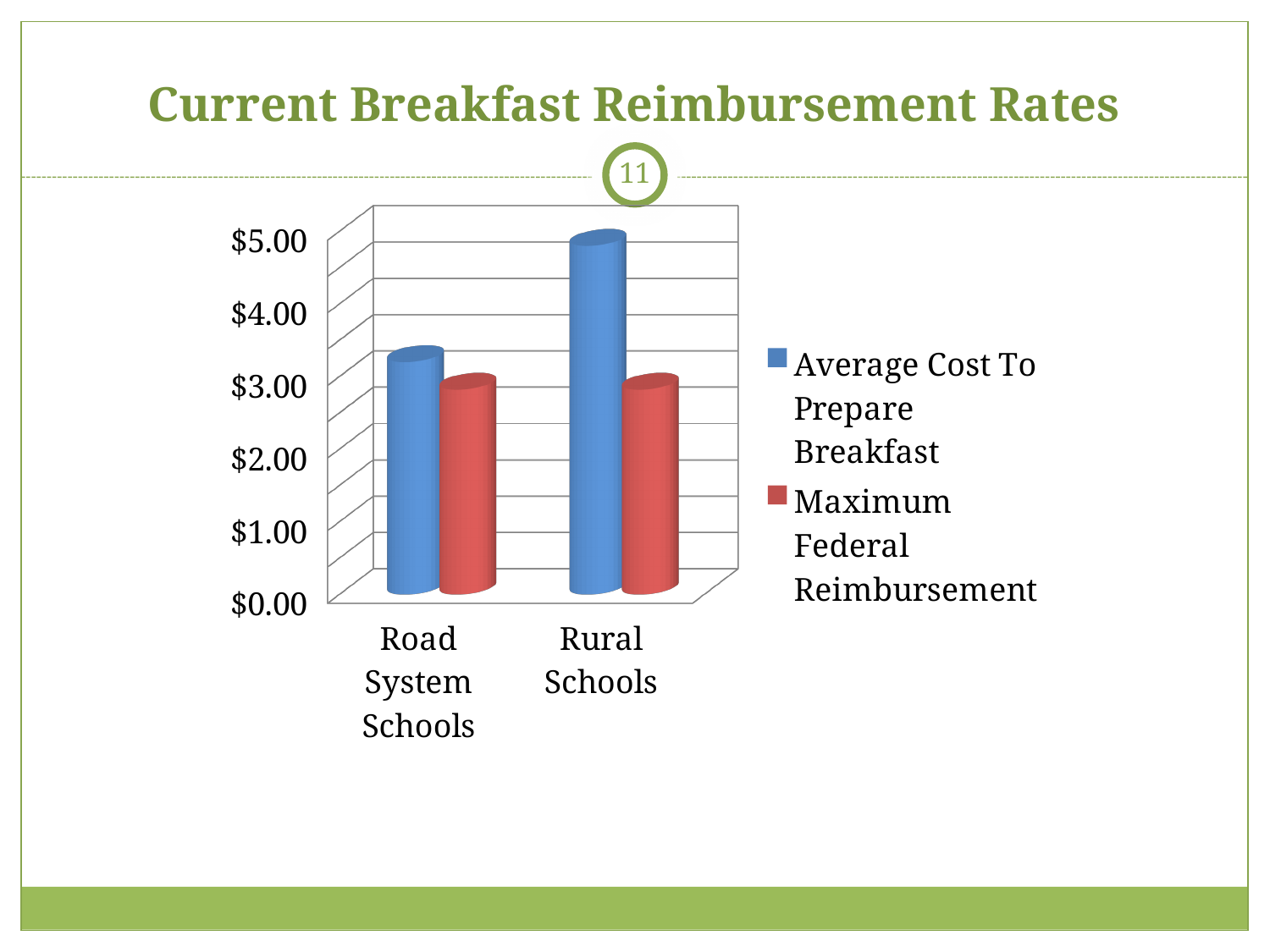
How many series does the legend list? 2 For Rural Schools, which is larger: the Average Cost To Prepare Breakfast or the Maximum Federal Reimbursement? Average Cost To Prepare Breakfast Is the Average Cost To Prepare Breakfast for Road System Schools greater or less than $3.00? greater What is the title of the chart on the slide? Current Breakfast Reimbursement Rates Which series is shown in red? Maximum Federal Reimbursement Is the Maximum Federal Reimbursement for Rural Schools greater or less than $2.00? greater Which category has the higher Average Cost To Prepare Breakfast? Rural Schools Is the Average Cost To Prepare Breakfast for Rural Schools greater or less than $4.00? greater How many categories are shown on the x axis? 2 What kind of chart is shown on the slide? bar chart Which is larger: the Average Cost To Prepare Breakfast for Rural Schools or for Road System Schools? Rural Schools